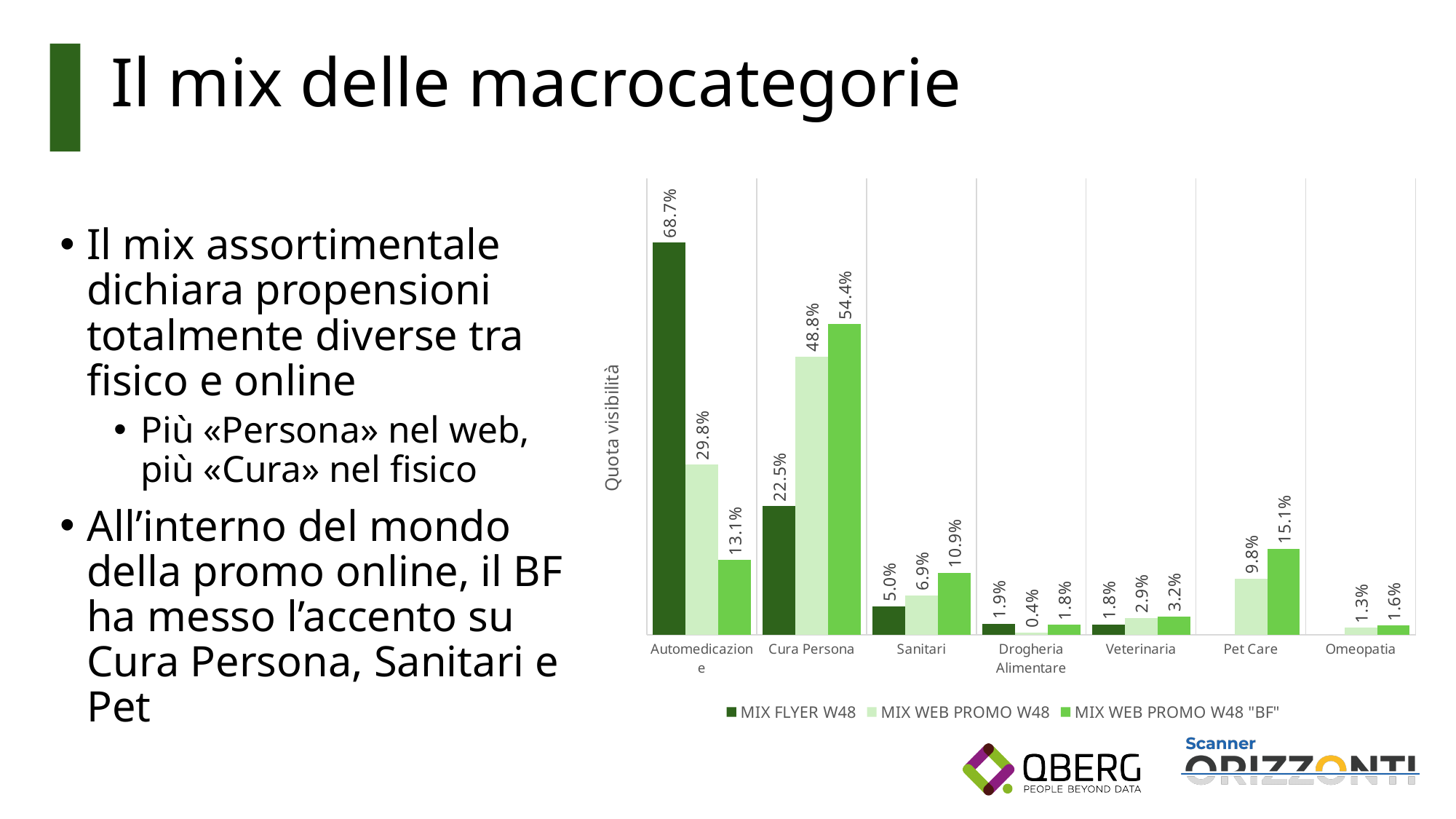
Which is larger for Cura Persona: the MIX FLYER W48 value or the MIX WEB PROMO W48 value? MIX WEB PROMO W48 Which category has the lowest MIX WEB PROMO W48 value? Drogheria Alimentare How many categories are shown on the x axis? 7 What is the difference between the MIX WEB PROMO W48 "BF" and MIX WEB PROMO W48 values for Sanitari? 4.0% What is the MIX FLYER W48 value for Automedicazione? 68.7% What is the MIX WEB PROMO W48 "BF" value for Cura Persona? 54.4% Which category has the highest MIX FLYER W48 value? Automedicazione What is the MIX WEB PROMO W48 value for Pet Care? 9.8% What type of chart is shown on the slide? Bar chart What is the difference between the MIX FLYER W48 value for Automedicazione and the MIX FLYER W48 value for Cura Persona? 46.2% How many series does the legend list? 3 What is the label of the vertical axis? Quota visibilità